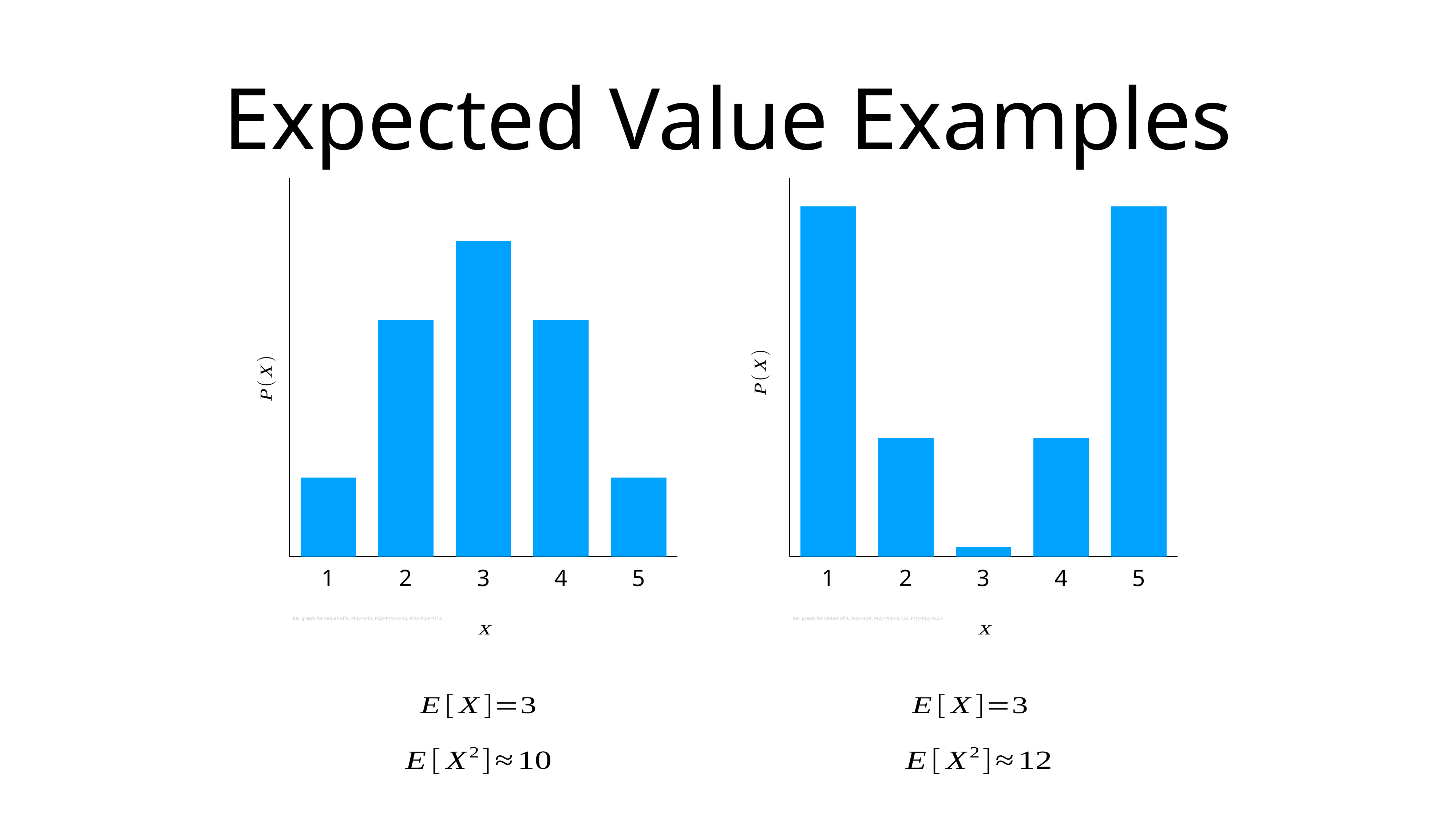
How many charts are shown on the slide? 2 In the right chart, which value of x has the lowest P(X)? 3 In the right chart, which has the larger P(X): x = 1 or x = 2? x = 1 What is the label on the vertical axis of the right chart? P(X) How many bars are in the left chart? 5 What kind of chart is the left chart? bar chart In the right chart, which has the larger P(X): x = 3 or x = 4? x = 4 In the left chart, which has the larger P(X): x = 3 or x = 5? x = 3 In the left chart, do the bars rise or fall from x = 3 to x = 5? fall How many bars are in the right chart? 5 In the left chart, which value of x has the highest P(X)? 3